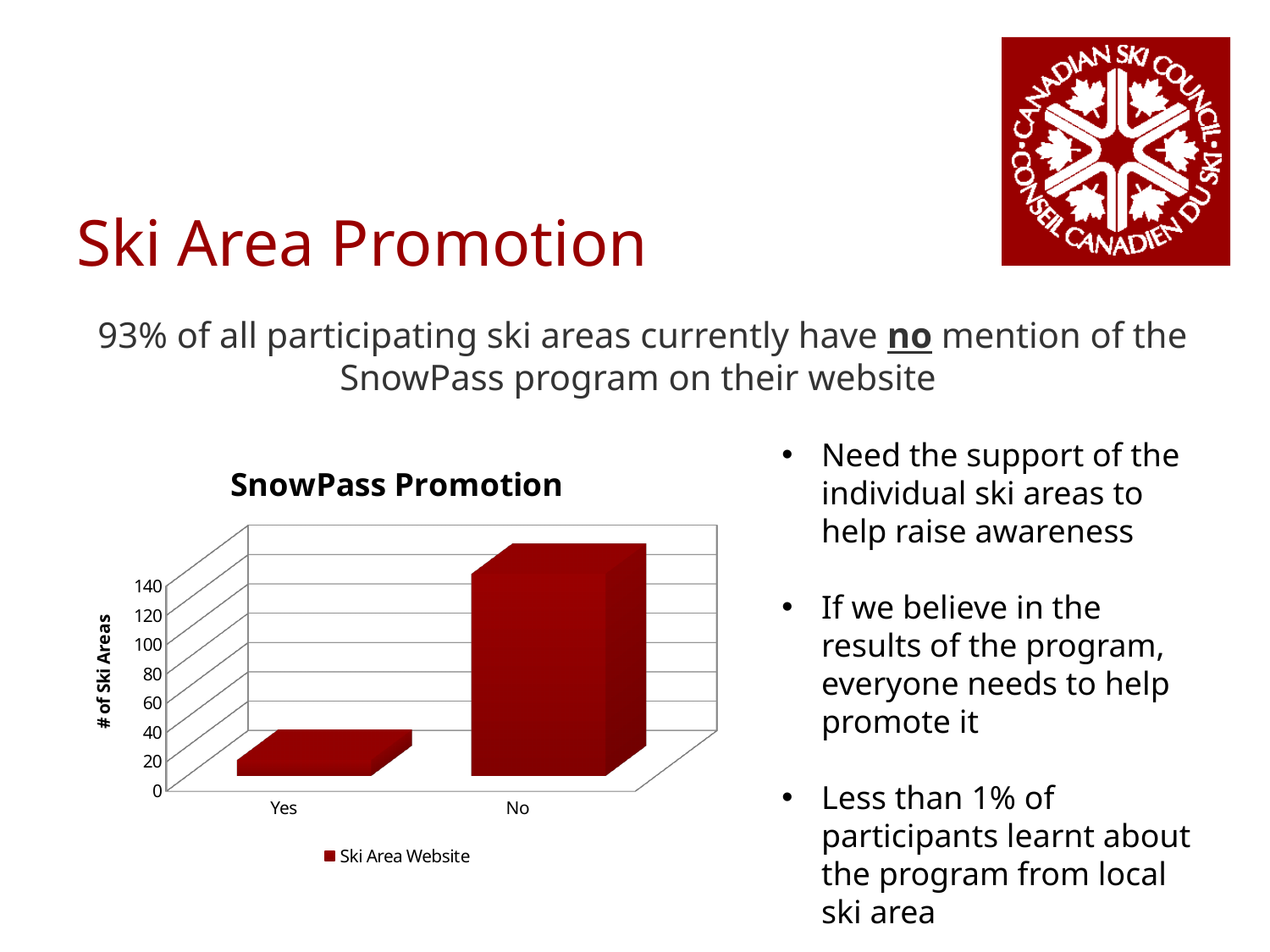
Is the value for Yes greater or less than 40? less Which category has the highest value in the chart? No How many categories are shown on the x axis of the chart? 2 What kind of chart is shown on the slide? Bar chart Is the value for No greater or less than 60? greater How many series does the chart legend list? 1 Which category has the lowest value in the chart? Yes What is the title of the chart? SnowPass Promotion Which is larger, the value for Yes or the value for No? No Is the value for Yes greater or less than 20? less What series name is shown in the chart legend? Ski Area Website